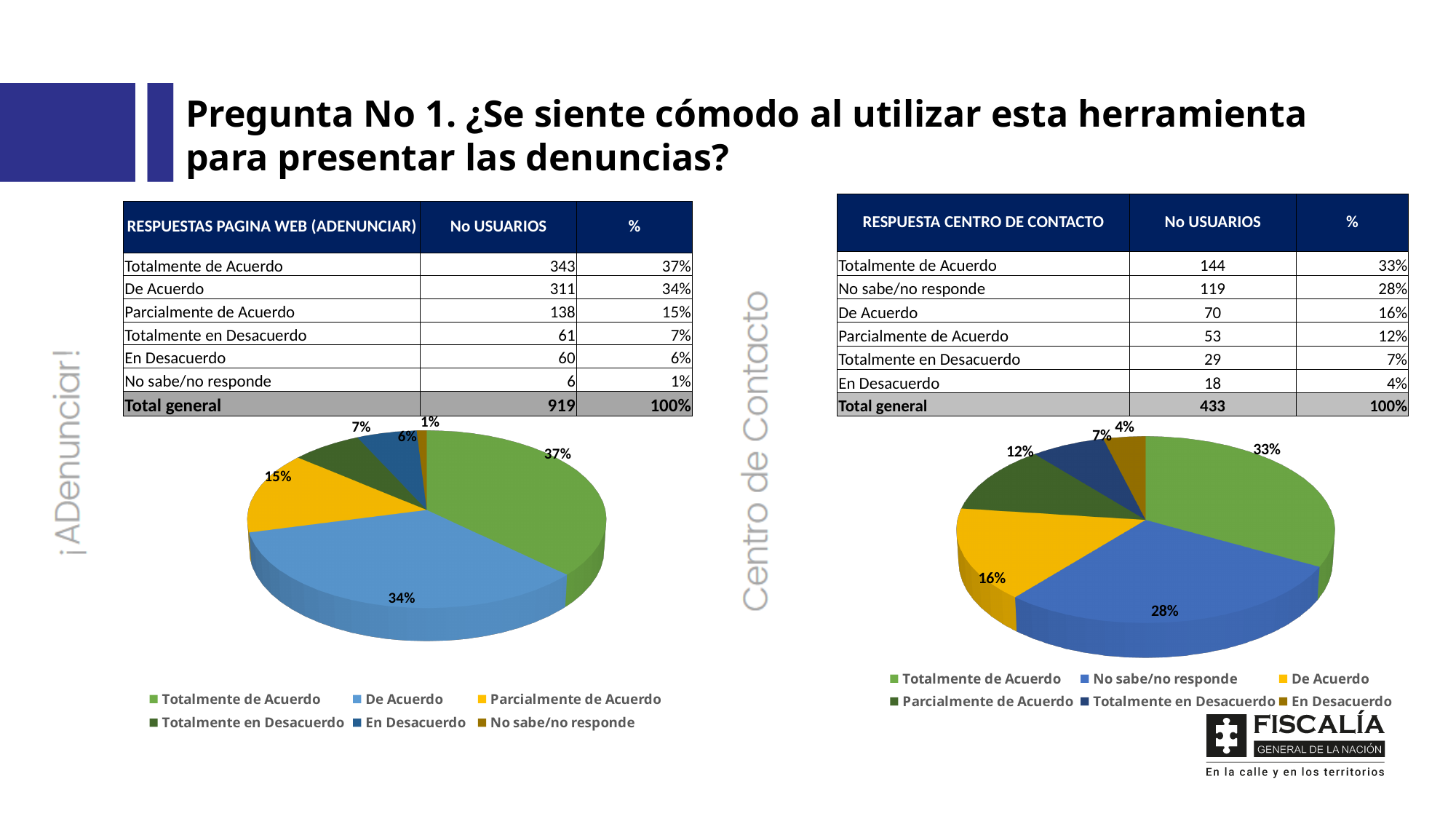
In the right pie chart (Centro de Contacto), which category has the largest slice? Totalmente de Acuerdo In the right pie chart (Centro de Contacto), which category has the smallest slice? En Desacuerdo In the left pie chart (ADenunciar), what is the difference between the 'Totalmente de Acuerdo' and 'De Acuerdo' shares? 3% What type of chart is used on the left side of the slide (ADenunciar)? Pie chart In the left pie chart (ADenunciar), which category has the smallest slice? No sabe/no responde In the right pie chart (Centro de Contacto), what share does 'No sabe/no responde' have? 28% In the left pie chart (ADenunciar), what share does 'Parcialmente de Acuerdo' have? 15% In the right pie chart (Centro de Contacto), what is the difference between the 'Totalmente de Acuerdo' and 'No sabe/no responde' shares? 5% In the right pie chart (Centro de Contacto), how many entries does the legend list? 6 In the left pie chart (ADenunciar), what share does 'Totalmente de Acuerdo' have? 37% In the right pie chart (Centro de Contacto), which is larger: 'De Acuerdo' or 'Parcialmente de Acuerdo'? De Acuerdo In the left pie chart (ADenunciar), how many slices are there? 6